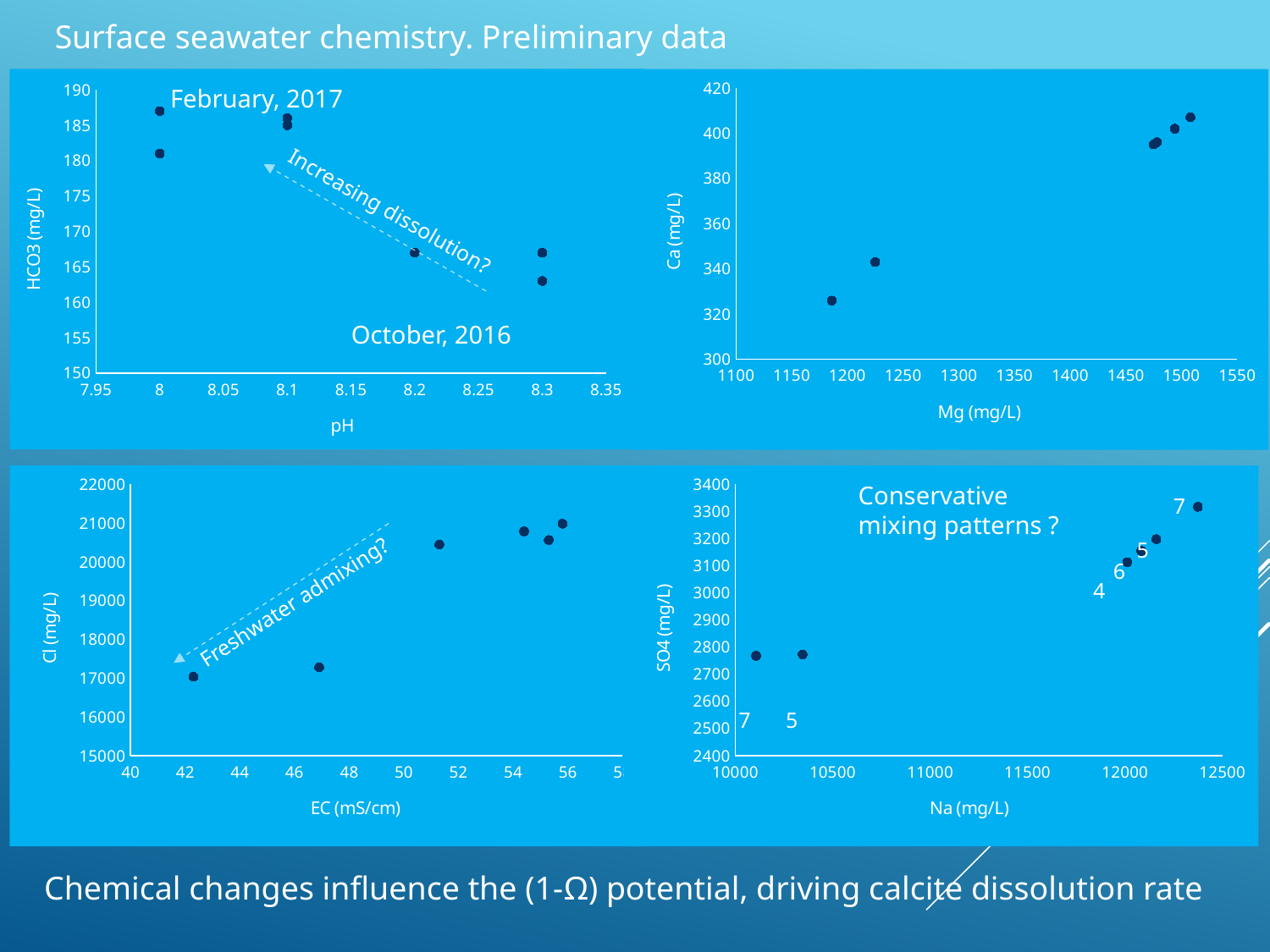
In the top-left chart, do HCO3 values rise or fall as pH increases along the x axis? fall In the bottom-left chart, is the Cl value for the point near EC 42 greater or less than 18000? less In the top-right chart, is the Ca value for the point near Mg 1200 greater or less than 340? less In the top-left chart, which points have higher HCO3: those at pH 8 or those at pH 8.3? those at pH 8 What annotation text is written along the dashed arrow in the bottom-left chart? Freshwater admixing? What is the x-axis label of the bottom-left chart? EC (mS/cm) What kind of chart is the top-left chart (HCO3 vs pH)? scatter chart In the top-right chart (Ca vs Mg), do Ca values rise or fall as Mg increases? rise In the top-right chart, are the Ca values for the points near Mg 1500 greater or less than 380? greater How many data points are plotted in the bottom-left chart (Cl vs EC)? 6